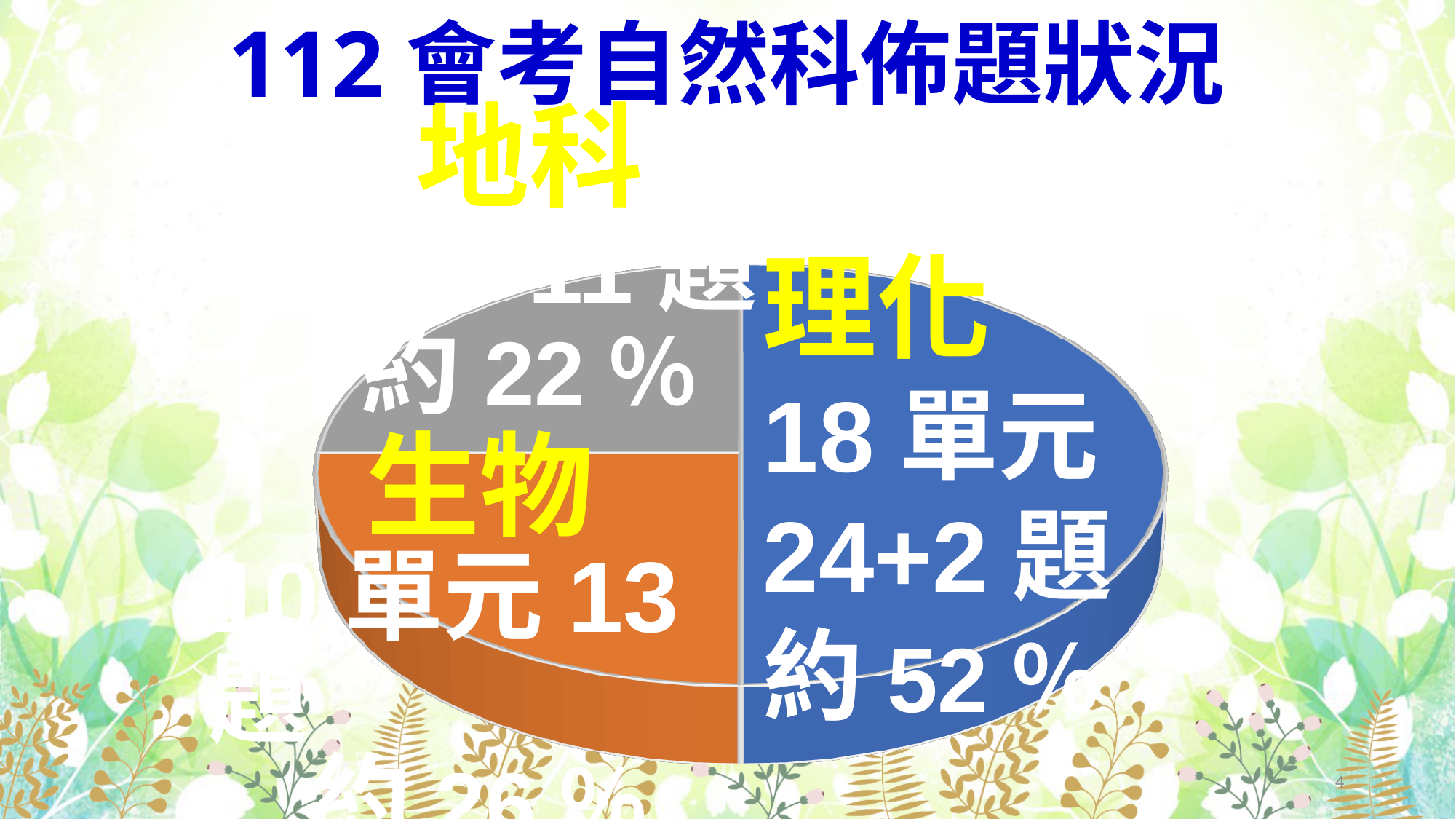
What percentage is shown for the 理化 slice? 約 52 % How many slices does the pie chart have? 3 How many 單元 are listed for 理化? 18 單元 What kind of chart is shown on the slide? pie chart How many 題 are listed for 理化? 24+2 題 What is the title of the slide? 112 會考自然科佈題狀況 How many 單元 are listed for 生物? 13 What colour is the 理化 slice? blue Which subject has the largest slice of the pie? 理化 What percentage is shown for the 地科 slice? 約 22 % Which slice is larger, 理化 or 地科? 理化